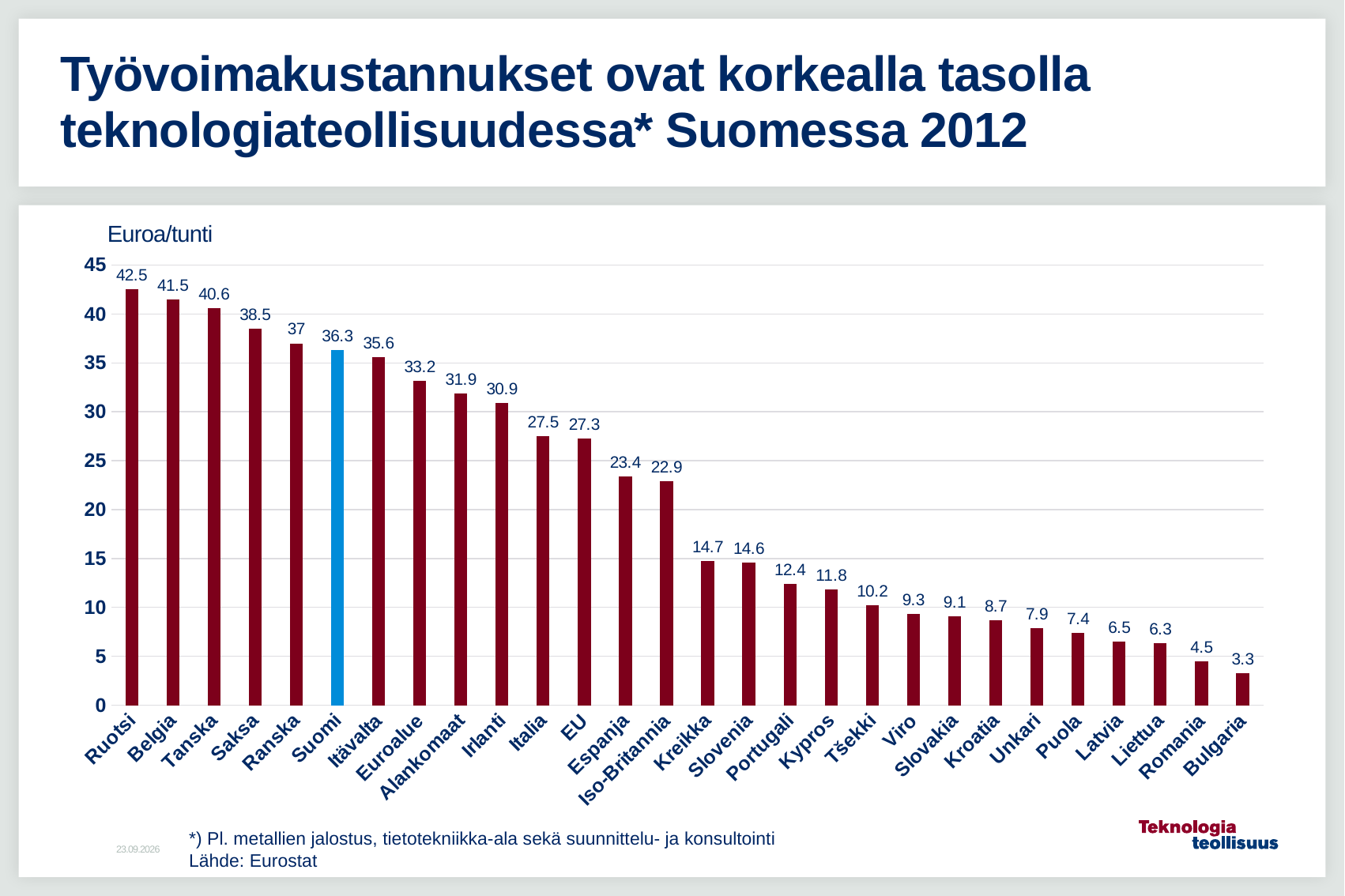
What is the value for Viro? 9.3 What is the difference between the values for Ruotsi and Suomi? 6.2 How many countries or regions are shown on the chart? 28 What kind of chart is shown on the slide? Bar chart What is the difference between the values for Euroalue and EU? 5.9 What unit is shown above the vertical axis? Euroa/tunti Which country has the lowest value? Bulgaria What is the value for Saksa? 38.5 What is the value for Iso-Britannia? 22.9 What is the value for Suomi? 36.3 Which country has the highest value? Ruotsi Which has a larger value, Belgia or Tanska? Belgia